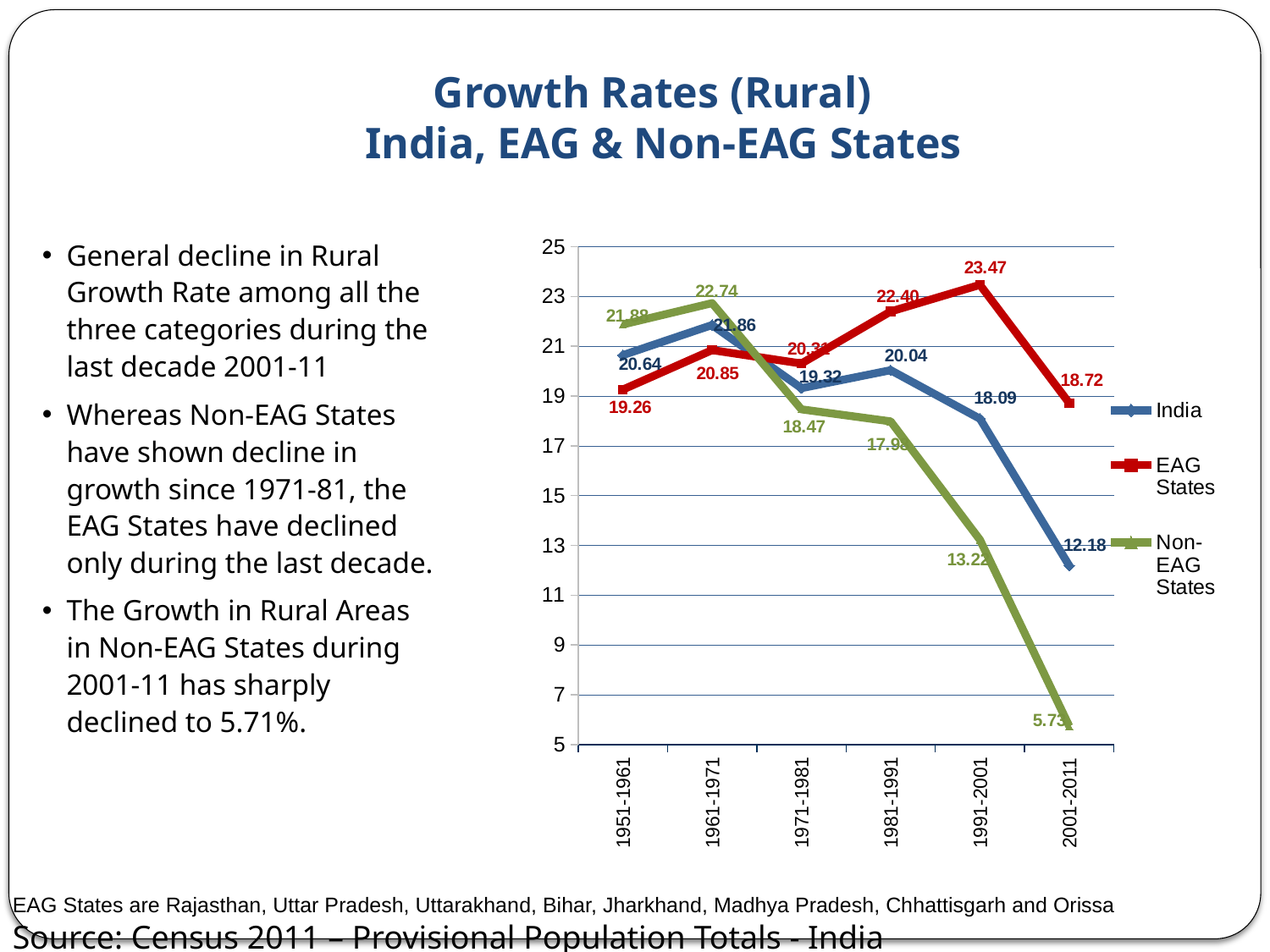
What is the value for EAG States in 1991-2001? 23.47 How many series does the legend list? 3 By how much did the EAG States value fall from 1991-2001 to 2001-2011? 4.75 What kind of chart is shown on the slide? Line chart In which period do the EAG States reach their highest value? 1991-2001 What is the value for EAG States in 1951-1961? 19.26 Is the value for Non-EAG States in 2001-2011 greater or less than 7? less What is the value for Non-EAG States in 1971-1981? 18.47 In 1991-2001, which is larger: the value for India or for EAG States? EAG States What is the rural growth rate for India in 2001-2011? 12.18 How many decade periods are shown on the x axis? 6 In which period is the value for India lowest? 2001-2011